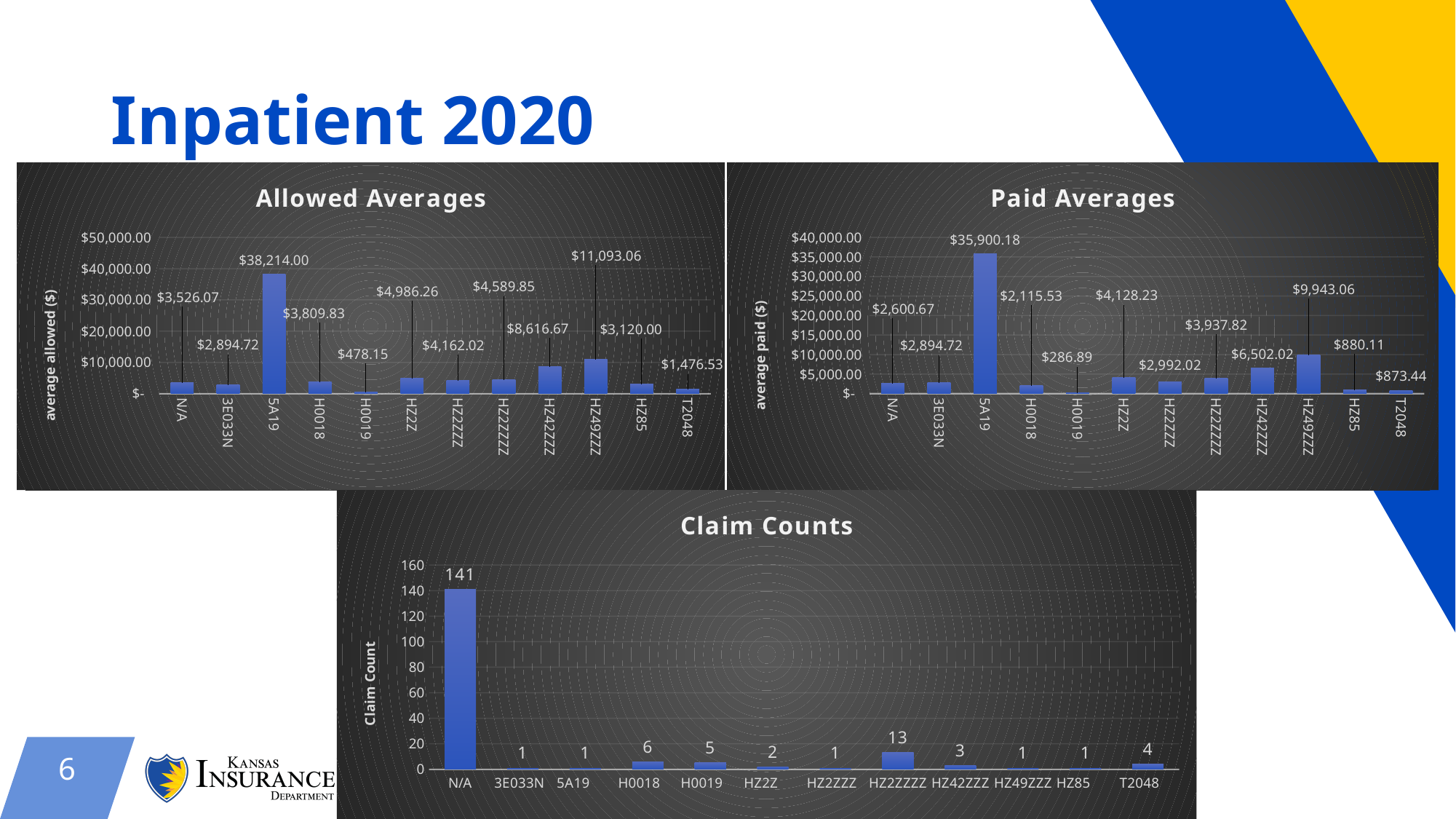
In the Allowed Averages chart, which category has the lowest value? H0019 How many categories are shown on the x axis of the Claim Counts chart? 12 In the Allowed Averages chart, which is larger, the value for HZ42ZZZ or the value for HZ2Z? HZ42ZZZ What type of chart is the Paid Averages chart? Bar chart In the Paid Averages chart, what is the value for HZ49ZZZ? $9,943.06 In the Paid Averages chart, which category has the highest value? 5A19 In the Claim Counts chart, what is the claim count for HZ2ZZZZ? 13 In the Claim Counts chart, which category has the highest claim count? N/A In the Claim Counts chart, what is the difference between the claim counts for N/A and HZ2ZZZZ? 128 In the Allowed Averages chart, what is the value for 5A19? $38,214.00 In the Paid Averages chart, what is the difference between the values for HZ42ZZZ and HZ2Z? $2,373.79 What is the y-axis label of the Allowed Averages chart? average allowed ($)